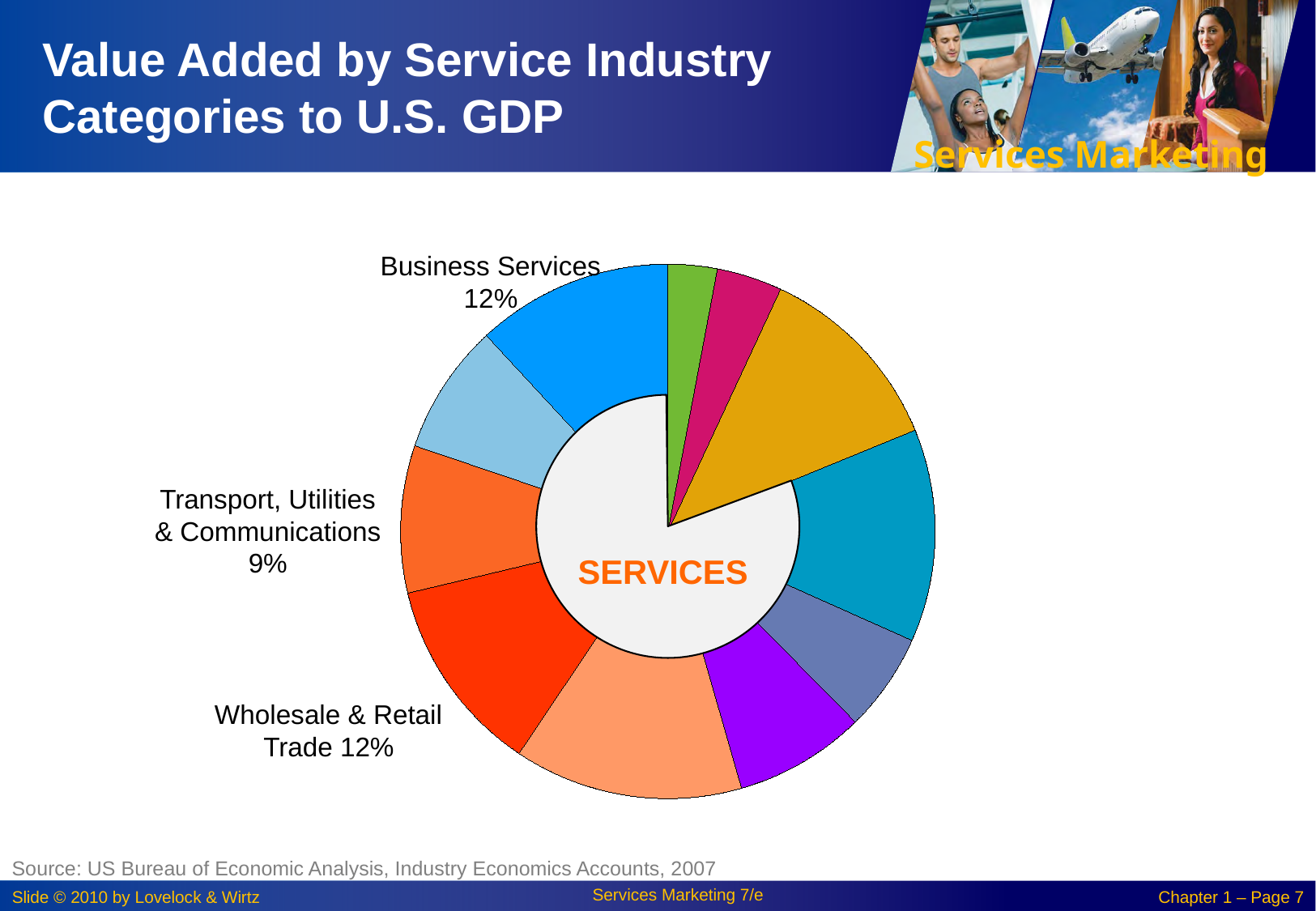
Which is larger, Wholesale & Retail Trade or Transport, Utilities & Communications? Wholesale & Retail Trade What percentage of U.S. GDP value added is attributed to Business Services in the pie chart? 12% What kind of chart is shown on the slide? Pie chart What is the difference between the Business Services share and the Transport, Utilities & Communications share? 3% Which is larger, the share for Business Services or the share for Transport, Utilities & Communications? Business Services Is the share for Transport, Utilities & Communications greater or less than 10%? less What word is printed in the centre of the pie chart? SERVICES What is the title of the slide containing the chart? Value Added by Service Industry Categories to U.S. GDP What share does the Transport, Utilities & Communications slice represent? 9% How many slices does the pie chart contain? 11 What is the value shown for Wholesale & Retail Trade? 12%